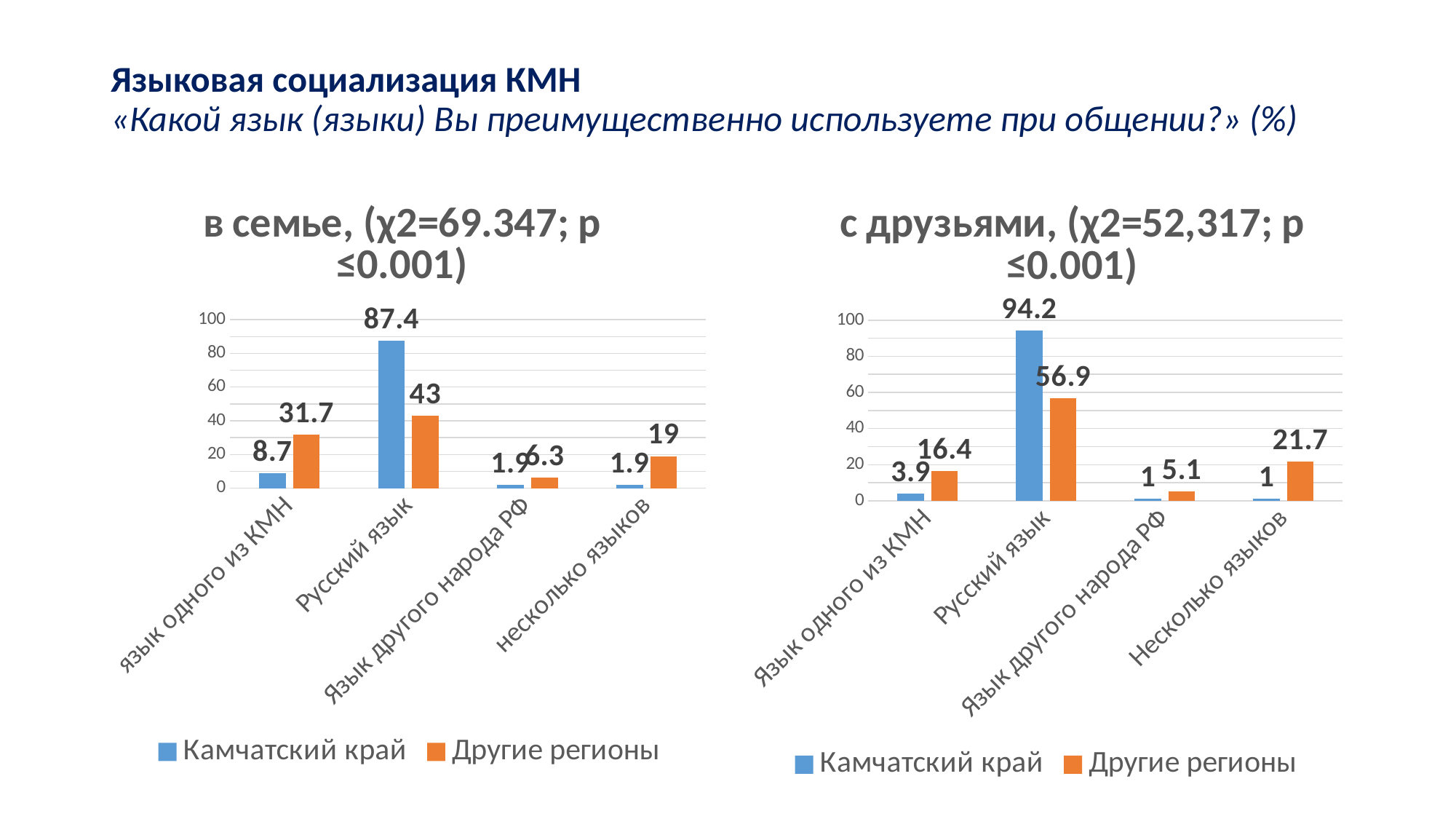
In the right chart (с друзьями), what is the value for Другие регионы for Русский язык? 56.9 In the left chart (в семье), what is the value for Другие регионы for язык одного из КМН? 31.7 In the left chart (в семье), which is larger for несколько языков: Камчатский край or Другие регионы? Другие регионы How many series does the legend of the left chart (в семье) list? 2 In the left chart (в семье), which category has the lowest value for Другие регионы? Язык другого народа РФ In the right chart (с друзьями), which category has the highest value for Камчатский край? Русский язык In the left chart (в семье), what is the value for Камчатский край for Русский язык? 87.4 In the left chart (в семье), what is the difference between Камчатский край and Другие регионы for Русский язык? 44.4 What type of chart is the left chart (в семье)? Bar chart How many categories are shown on the x axis of the right chart (с друзьями)? 4 In the right chart (с друзьями), what is the value for Камчатский край for несколько языков? 1 In the right chart (с друзьями), what is the difference between Другие регионы and Камчатский край for несколько языков? 20.7